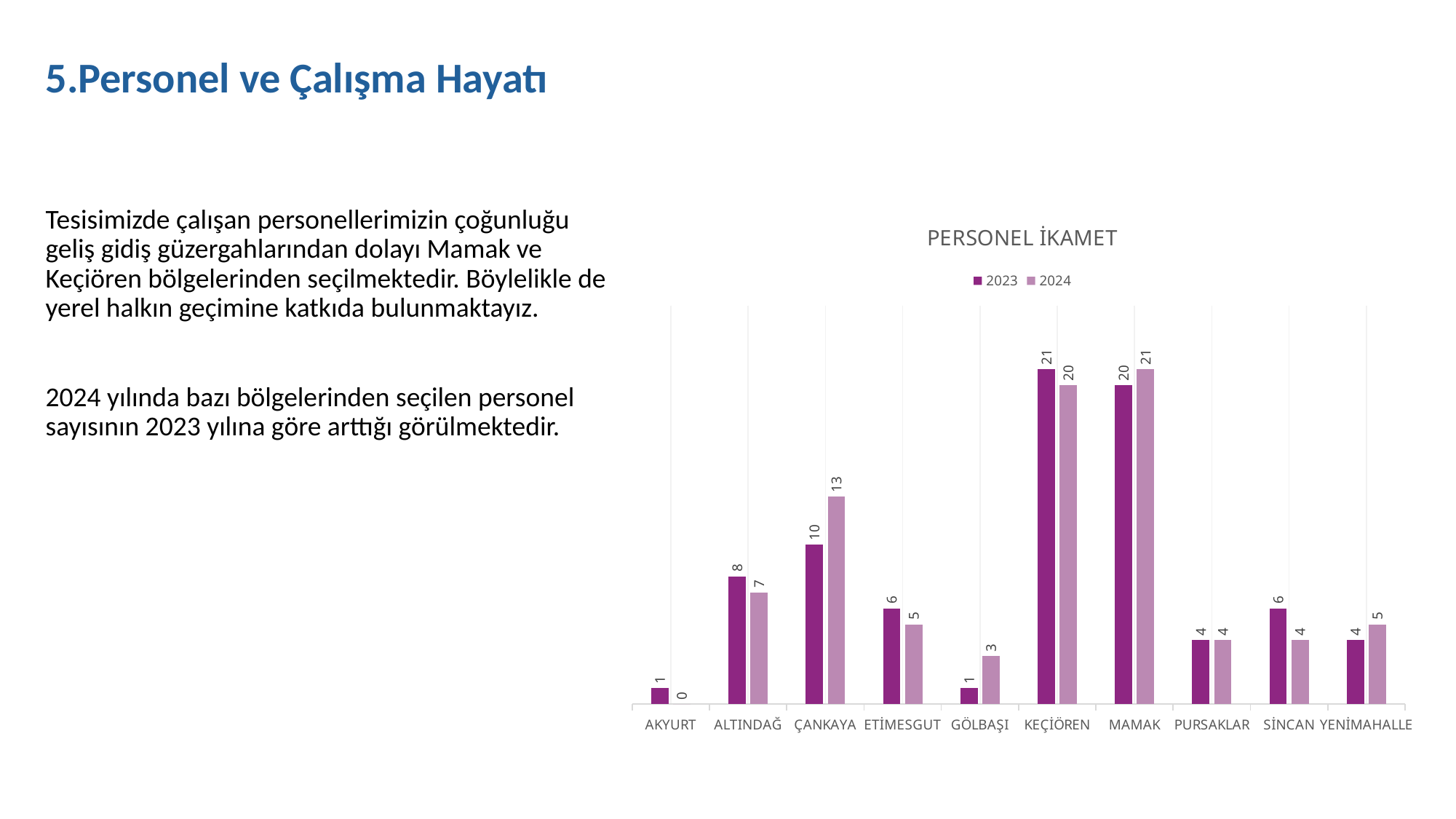
What is the 2023 value for ÇANKAYA in the PERSONEL İKAMET chart? 10 How many series does the legend list? 2 What is the 2024 value for KEÇİÖREN? 20 What is the title of the chart? PERSONEL İKAMET What is the 2024 value for AKYURT? 0 What is the difference between the 2024 and 2023 values for ÇANKAYA? 3 Which category has the lowest 2024 value? AKYURT Which is larger for SİNCAN, the 2023 value or the 2024 value? 2023 What kind of chart is shown on the slide? Bar chart Which category has the highest 2024 value? MAMAK Which category has the highest 2023 value? KEÇİÖREN How many categories are shown on the x axis of the chart? 10